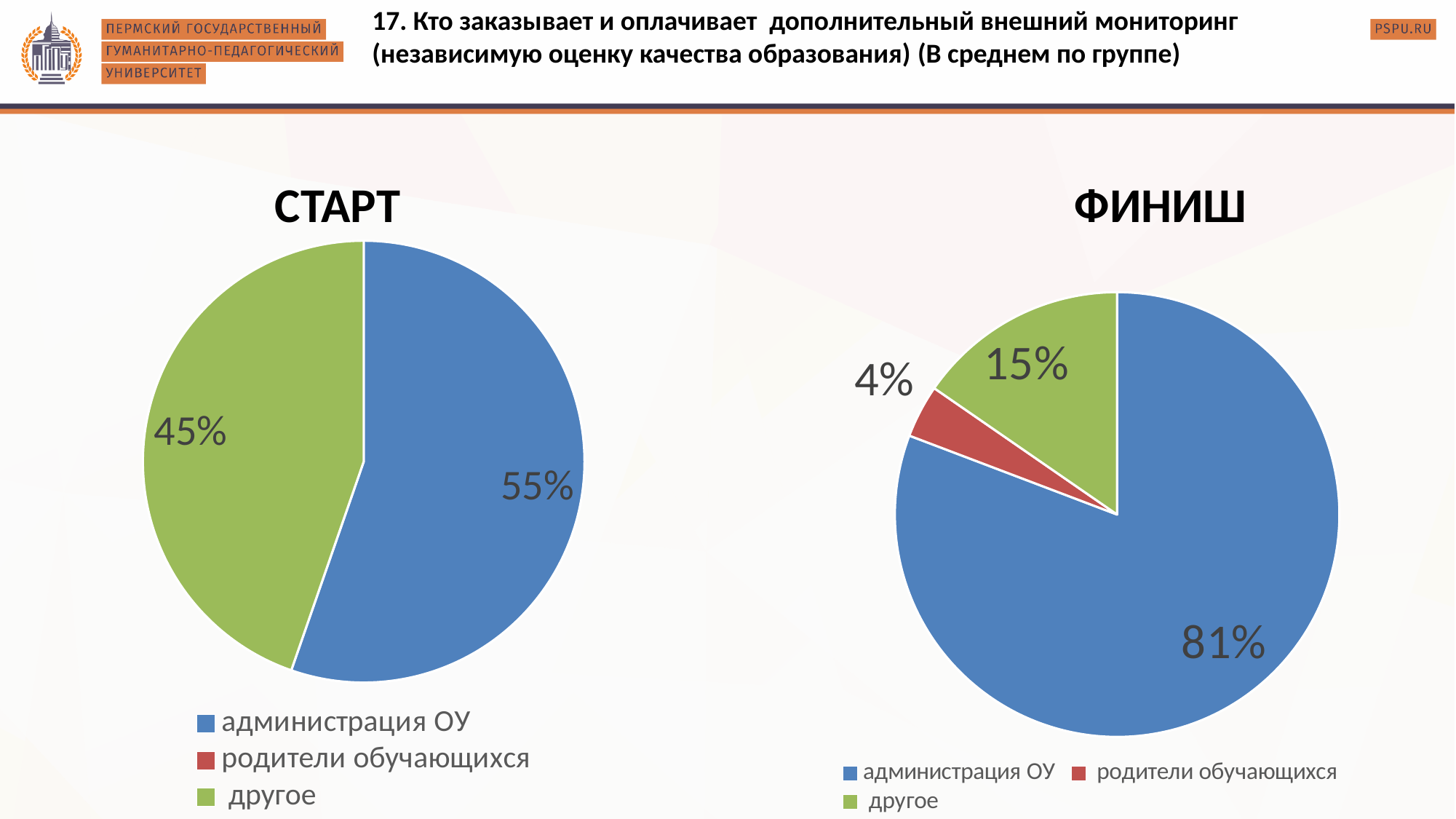
In the ФИНИШ chart, which category has the largest slice? администрация ОУ In the ФИНИШ chart, what share is labelled for родители обучающихся? 4% In the СТАРТ chart, what share is labelled for администрация ОУ? 55% In the СТАРТ chart, what share is labelled for другое? 45% In the СТАРТ chart, what is the difference between the shares for администрация ОУ and другое? 10% In the ФИНИШ chart, which category has the smallest slice? родители обучающихся What type of chart is the СТАРТ chart? pie chart In the ФИНИШ chart, what share is labelled for администрация ОУ? 81% How many entries does the legend of the ФИНИШ chart list? 3 Which chart shows a larger share for администрация ОУ, СТАРТ or ФИНИШ? ФИНИШ In the ФИНИШ chart, what share is labelled for другое? 15% In the ФИНИШ chart, what is the difference between the shares for другое and родители обучающихся? 11%